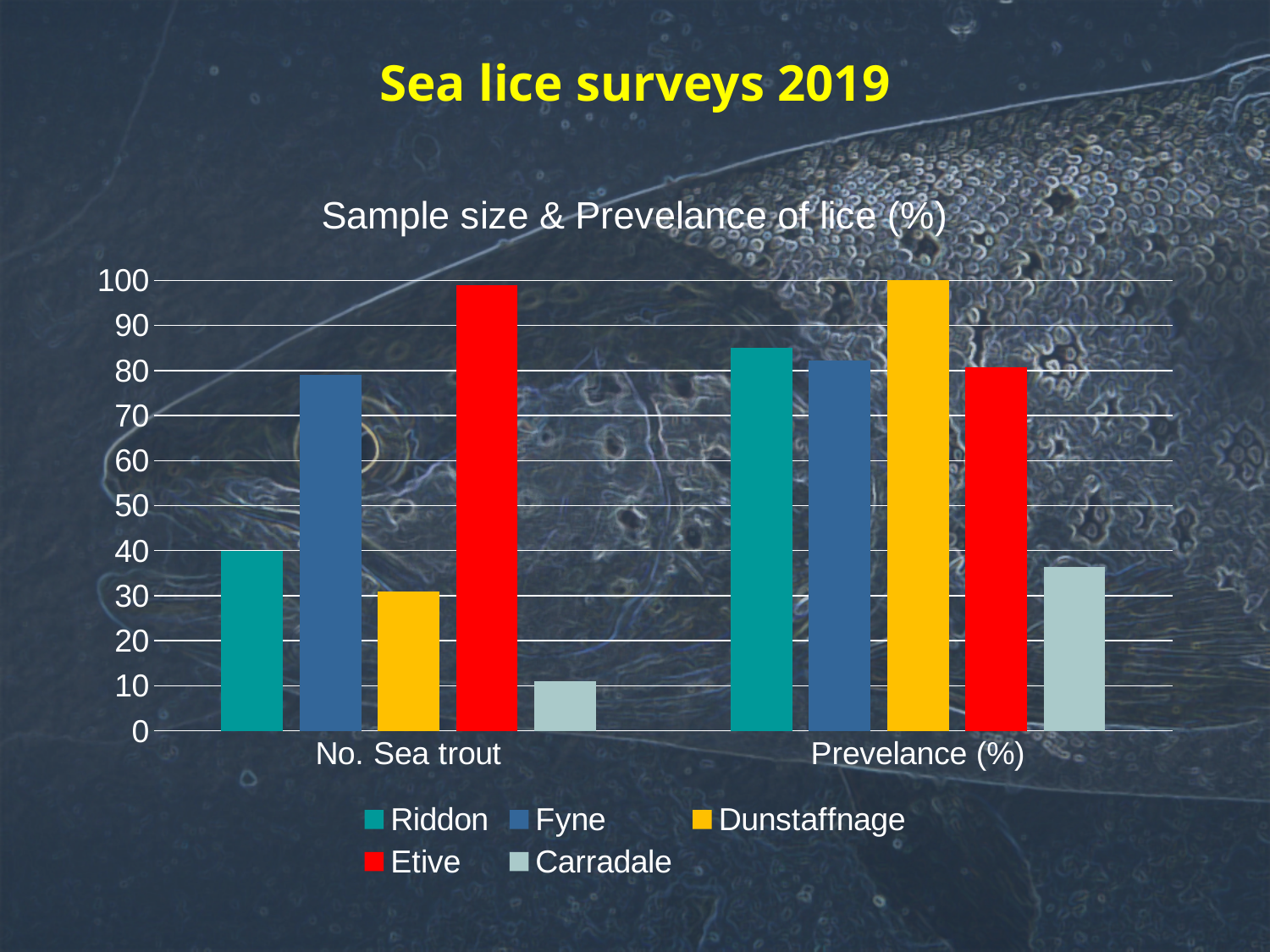
Which series has the highest value for No. Sea trout? Etive For No. Sea trout, which is larger: Fyne or Riddon? Fyne Which series has the highest value for Prevelance (%)? Dunstaffnage What type of chart is shown on the slide? bar chart Which series has the lowest value for Prevelance (%)? Carradale Is the Prevelance (%) value for Carradale greater or less than 40? less Is the No. Sea trout value for Fyne greater or less than 70? greater What is the Prevelance (%) value for Dunstaffnage? 100 How many series does the legend list? 5 What is the title of the chart? Sample size & Prevelance of lice (%) How many categories are shown on the x axis? 2 Which series has the lowest value for No. Sea trout? Carradale